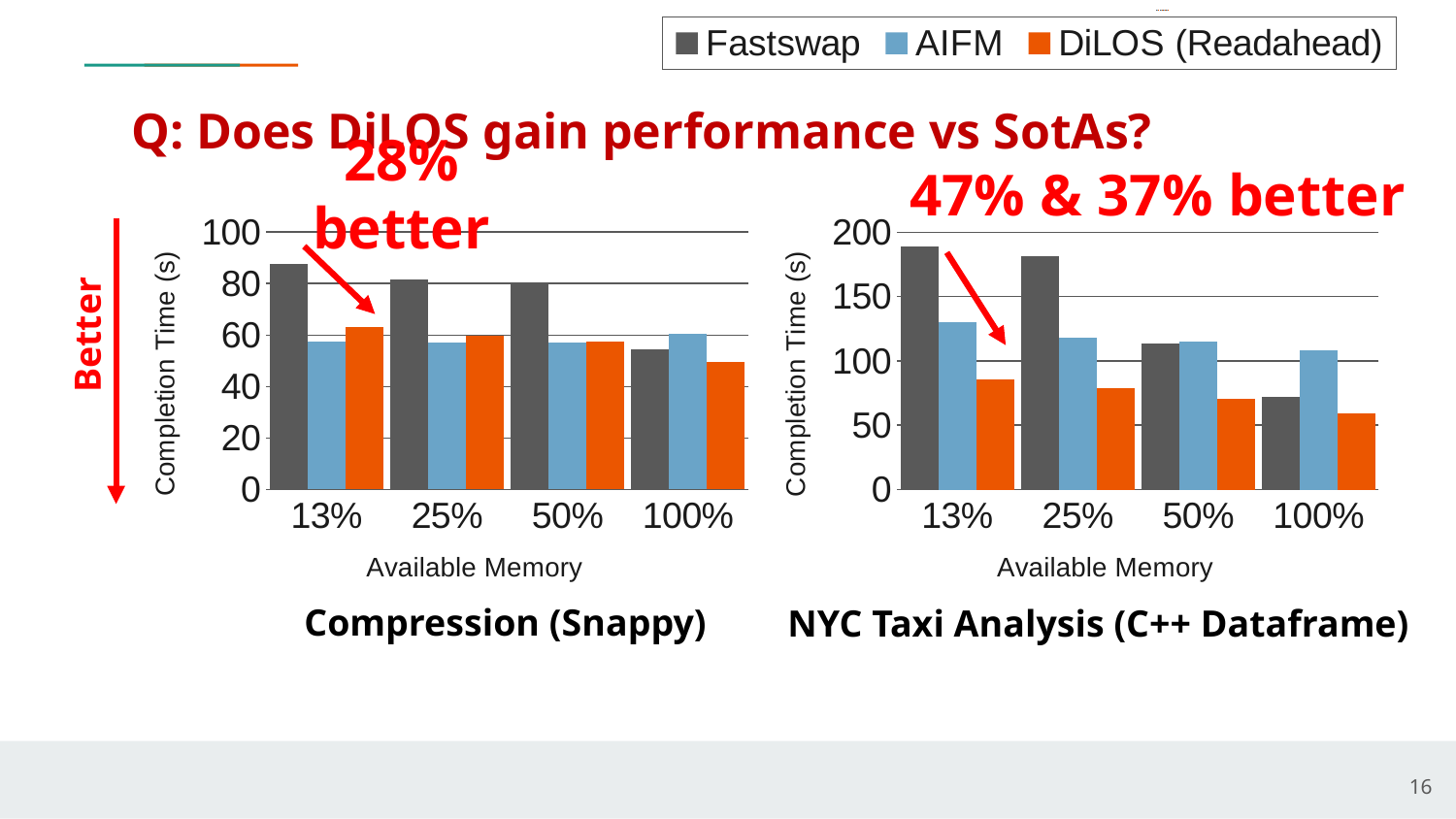
In the NYC Taxi Analysis (C++ Dataframe) chart, do the Fastswap values rise or fall as Available Memory increases from 13% to 100%? fall In the Compression (Snappy) chart, which is larger at 100% Available Memory: Fastswap or AIFM? AIFM In the NYC Taxi Analysis (C++ Dataframe) chart, which series has the lowest completion time at 100%? DiLOS (Readahead) What kind of chart is the Compression (Snappy) chart? bar chart In the NYC Taxi Analysis (C++ Dataframe) chart, is the DiLOS (Readahead) value at 13% greater or less than 100? less In the NYC Taxi Analysis (C++ Dataframe) chart, is the Fastswap value at 25% greater or less than 150? greater How many series does the legend list? 3 How many Available Memory categories are shown on the x axis of the NYC Taxi Analysis (C++ Dataframe) chart? 4 What is the y-axis label on both charts? Completion Time (s) In the NYC Taxi Analysis (C++ Dataframe) chart, which series has the highest completion time at 13%? Fastswap In the Compression (Snappy) chart, is the Fastswap value at 13% greater or less than 80? greater In the NYC Taxi Analysis (C++ Dataframe) chart, which is larger at 100% Available Memory: AIFM or Fastswap? AIFM